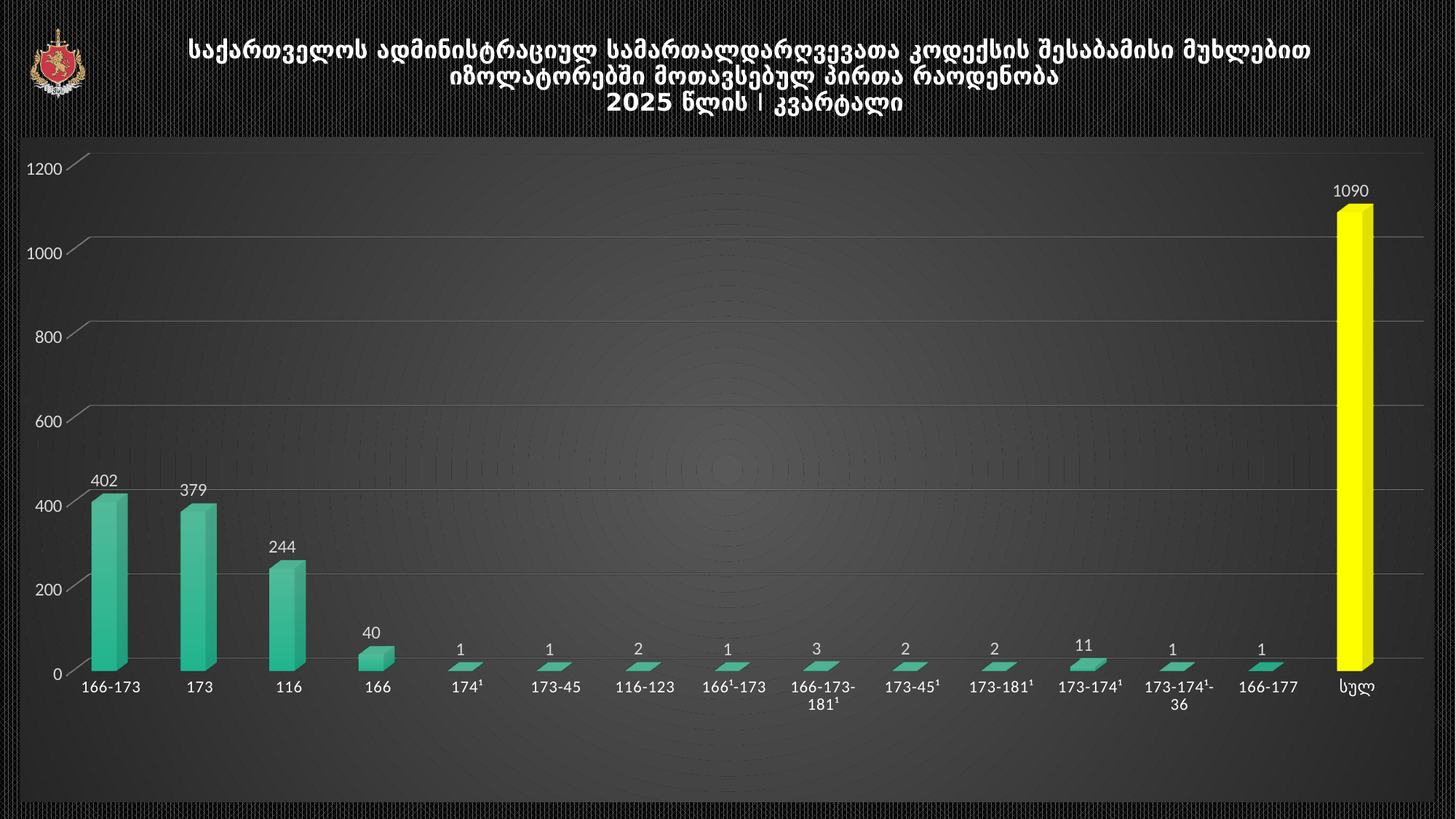
What kind of chart is shown on the slide? bar chart What is the value for the category 173-174¹? 11 How many categories are shown on the x axis? 15 What is the difference between the values for 166-173 and 173? 23 Which is larger, the value for 173 or the value for 116? 173 What is the value for the category 173? 379 What is the difference between the values for 116 and 166? 204 What is the value for the category 166-173? 402 What is the value for the category 116? 244 Is the value for სულ greater or less than 1000? greater Excluding the total bar სულ, which category has the highest value? 166-173 What is the value shown for the yellow bar labelled სულ? 1090